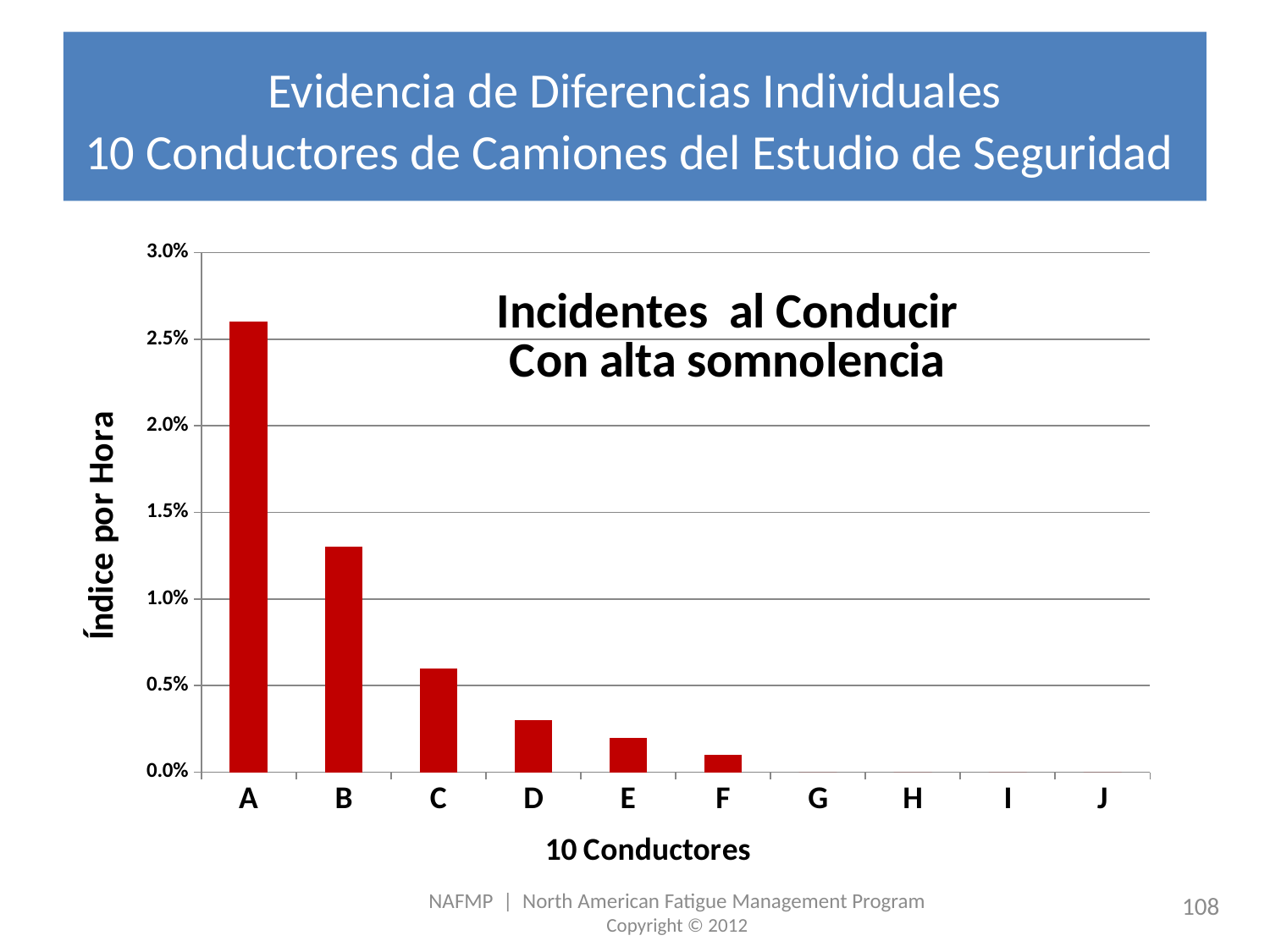
Is the value for driver B greater or less than 1.0%? greater Is the value for driver B greater or less than 1.5%? less Is the value for driver A greater or less than 2.5%? greater What is the label of the y axis of the chart? Índice por Hora Do the values rise or fall moving from driver A to driver J along the x axis? fall Which driver has a higher incident rate, driver A or driver B? A Which driver has the highest rate of incidents while driving with high drowsiness? A How many drivers (conductores) are shown on the x axis of the chart? 10 What kind of chart is shown on the slide? bar chart Which driver has a higher incident rate, driver C or driver E? C